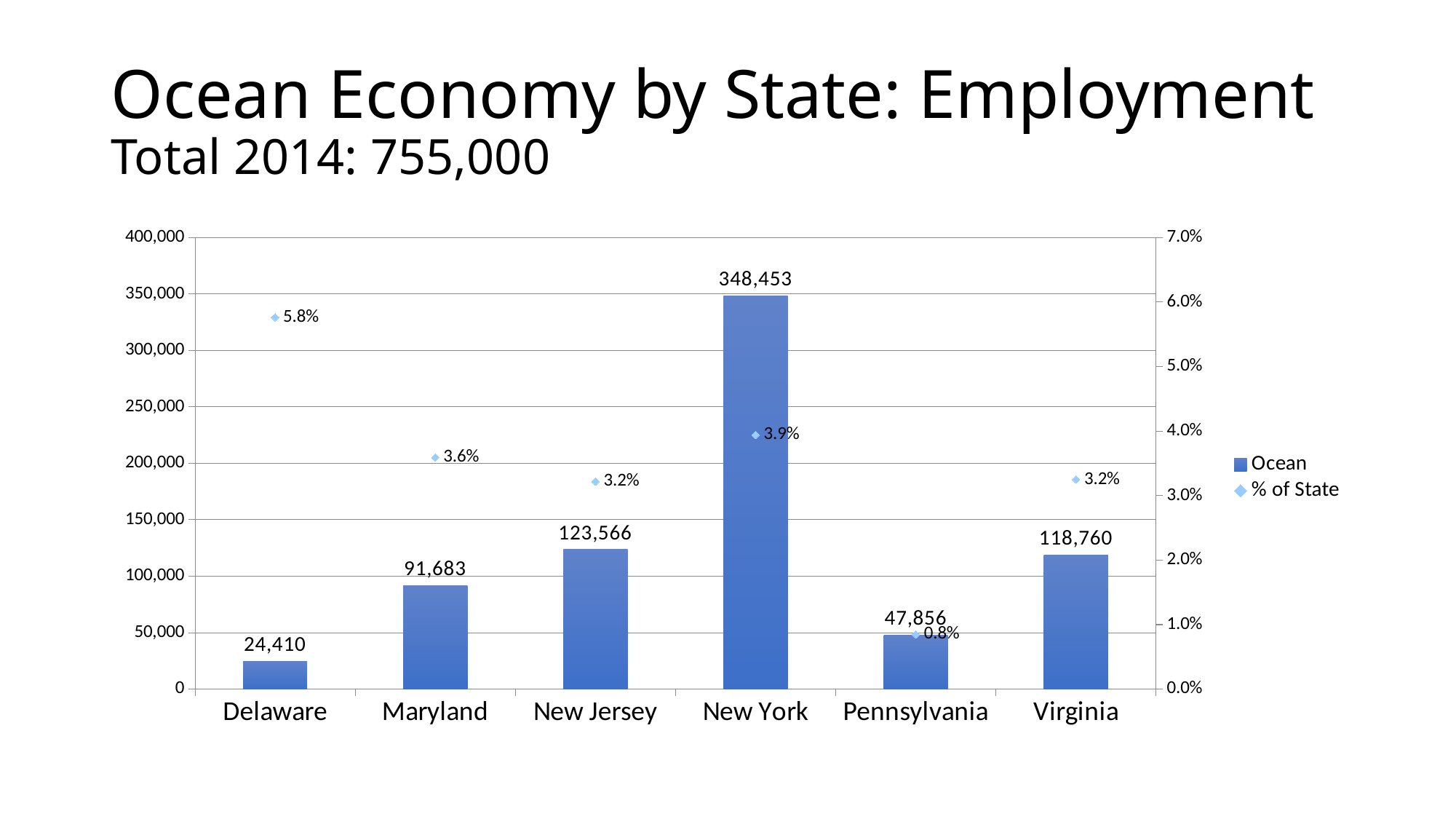
What is the total 2014 employment stated in the slide subtitle? 755,000 What is the % of State value for Pennsylvania? 0.8% Which state has the highest % of State value? Delaware Which has a larger Ocean employment value, Maryland or Pennsylvania? Maryland How many series does the legend list? 2 What is the % of State value for Maryland? 3.6% What is the Ocean employment value for Delaware? 24,410 Which state has the highest Ocean employment? New York Which state has the lowest % of State value? Pennsylvania What is the Ocean employment value for New York? 348,453 How many states are shown on the x axis? 6 What is the difference in Ocean employment between New Jersey and Virginia? 4,806